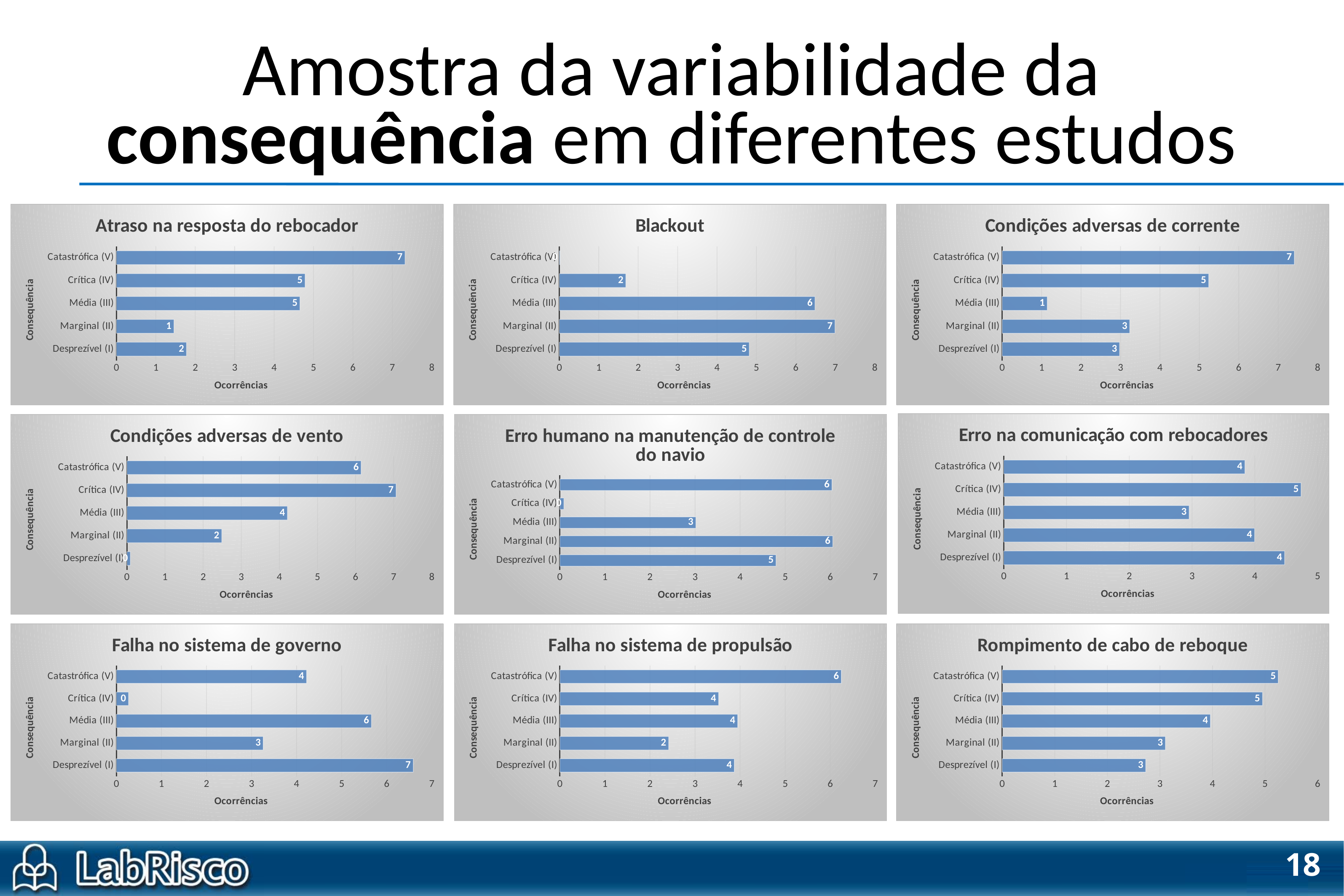
In the 'Blackout' chart, which category has the highest value? Marginal (II) How many categories are shown in the 'Blackout' chart? 5 In the 'Atraso na resposta do rebocador' chart, what is the value for Catastrófica (V)? 7 In the 'Erro humano na manutenção de controle do navio' chart, what is the value for Desprezível (I)? 5 In the 'Condições adversas de corrente' chart, which category has the lowest value? Média (III) In the 'Falha no sistema de governo' chart, which category has the highest value? Desprezível (I) In the 'Blackout' chart, what is the value for Crítica (IV)? 2 In the 'Condições adversas de vento' chart, what is the difference between Crítica (IV) and Marginal (II)? 5 In the 'Falha no sistema de propulsão' chart, what is the value for Marginal (II)? 2 In the 'Rompimento de cabo de reboque' chart, what is the difference between Catastrófica (V) and Desprezível (I)? 2 In the 'Erro na comunicação com rebocadores' chart, which is larger, Crítica (IV) or Média (III)? Crítica (IV) What type of chart is 'Falha no sistema de governo'? Bar chart